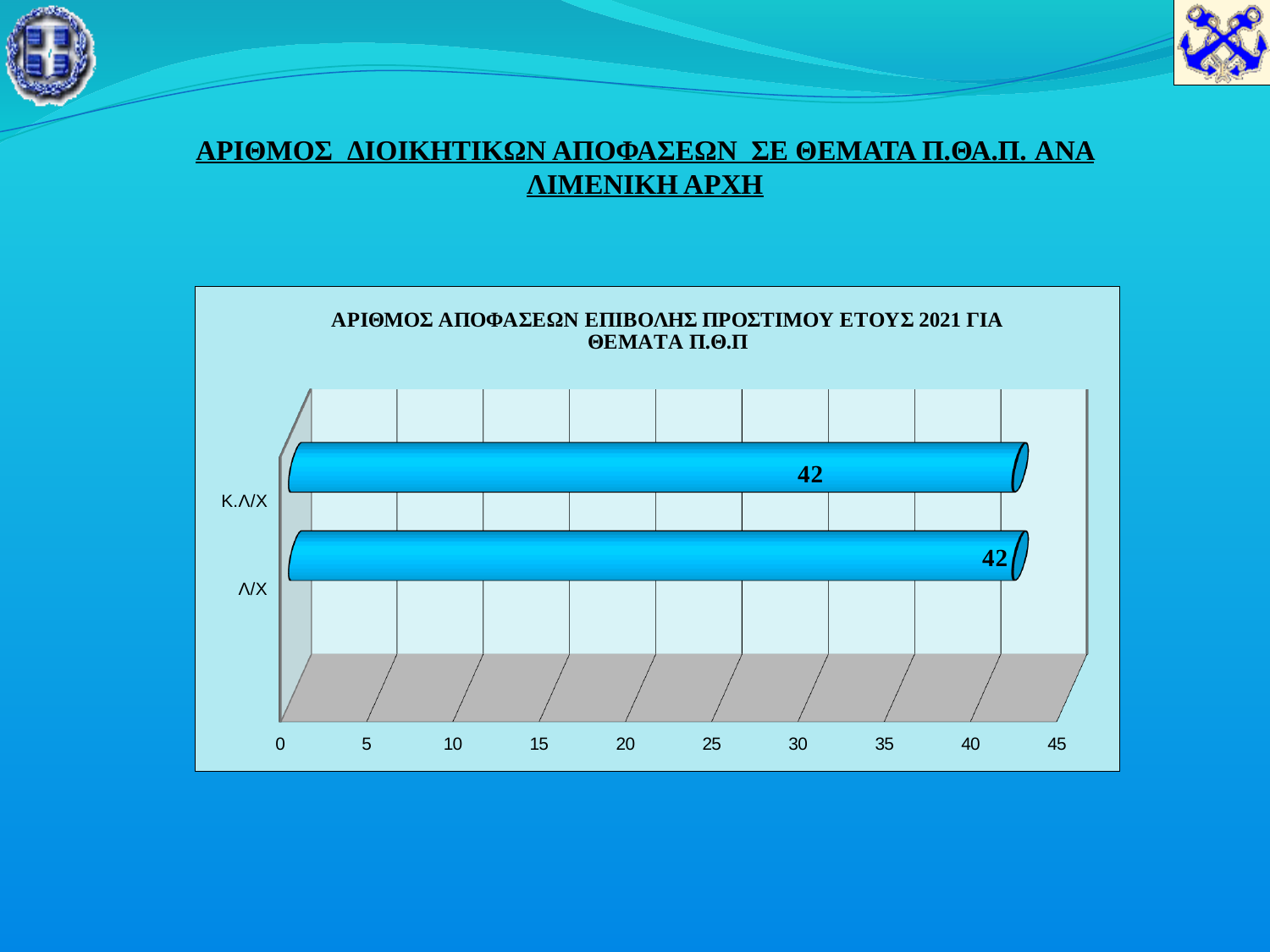
What is the value for Λ/Χ? 42 What year is mentioned in the chart title? 2021 What is the difference between the values for Κ.Λ/Χ and Λ/Χ? 0 Is the value for Λ/Χ greater or less than 45? less Do the two categories Κ.Λ/Χ and Λ/Χ have the same value? Yes How many categories are shown on the chart? 2 Is the value for Κ.Λ/Χ greater or less than 40? greater What is the value for Κ.Λ/Χ? 42 What is the maximum value shown on the horizontal axis of the chart? 45 What kind of chart is shown on the slide? bar chart